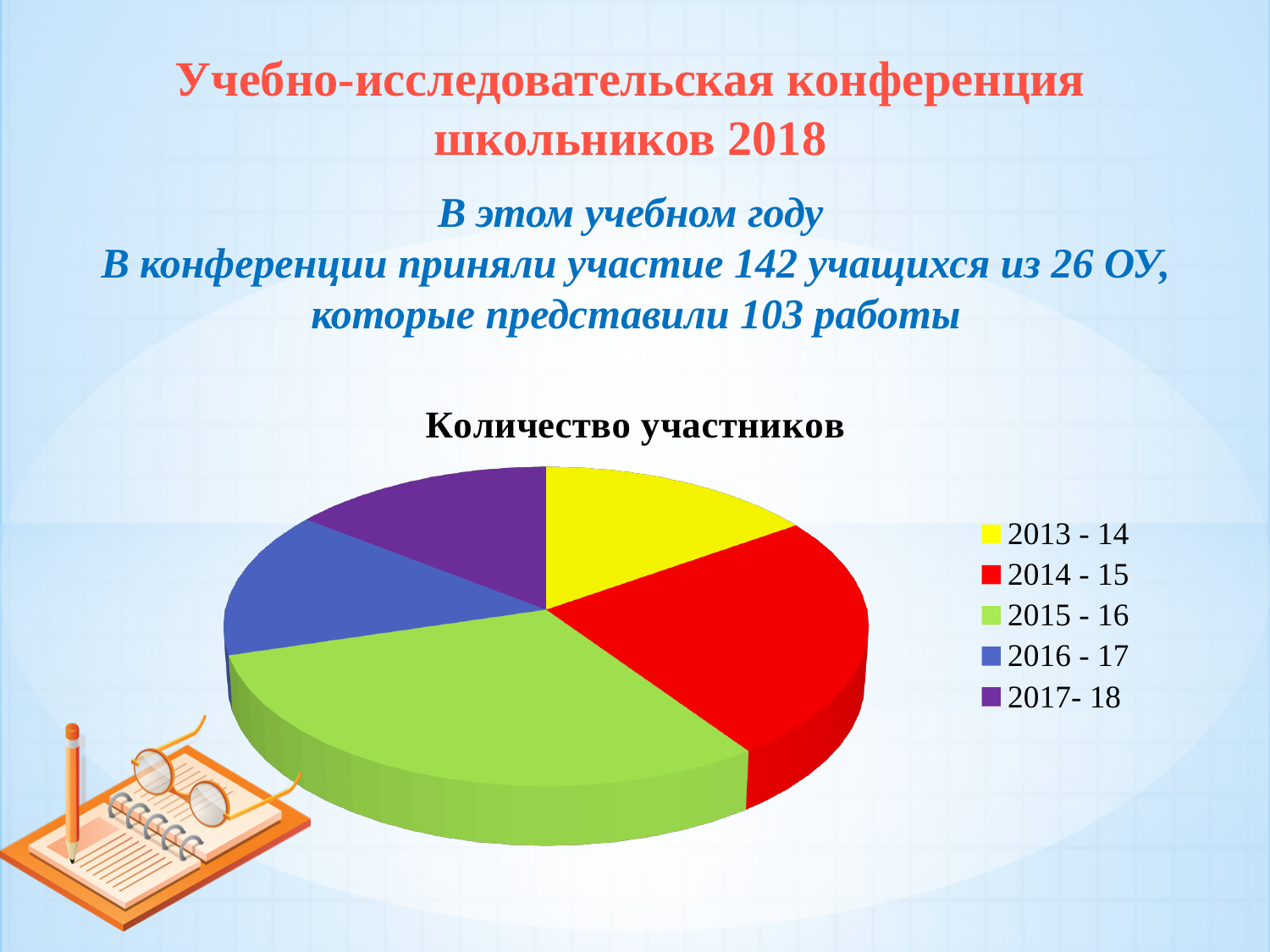
Which slice is larger, 2014 - 15 or 2013 - 14? 2014 - 15 What colour represents 2015 - 16 in the pie chart? green Which slice is larger, 2014 - 15 or 2017- 18? 2014 - 15 What kind of chart is shown on the slide? pie chart Which academic year has the largest slice of the pie? 2015 - 16 How many slices does the pie chart have? 5 What is the title of the chart? Количество участников Which slice is larger, 2015 - 16 or 2016 - 17? 2015 - 16 How many entries does the legend list? 5